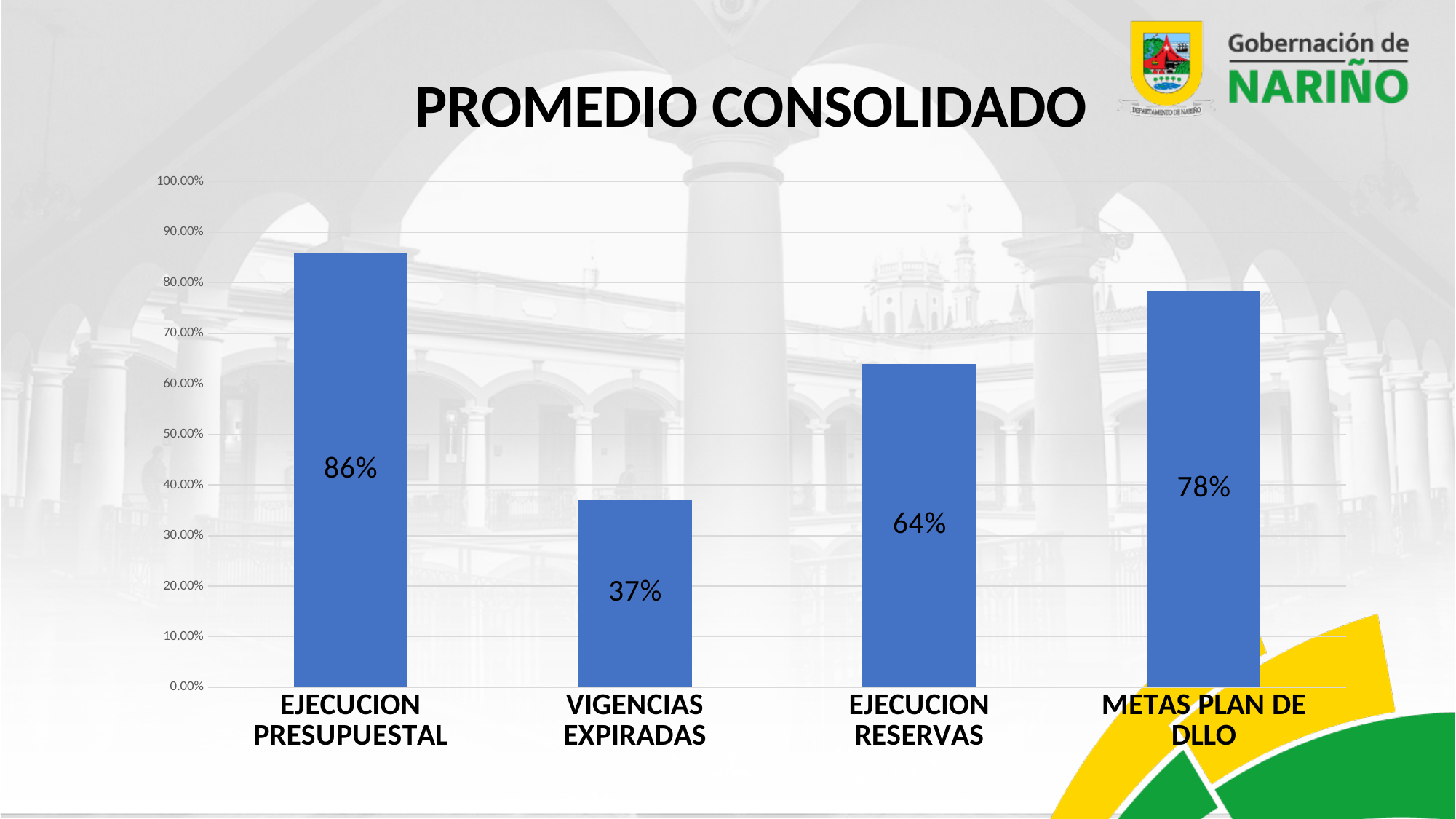
What is the value for VIGENCIAS EXPIRADAS? 37% Which is larger, the value for EJECUCION RESERVAS or the value for METAS PLAN DE DLLO? METAS PLAN DE DLLO Which category has the lowest value? VIGENCIAS EXPIRADAS How many categories are shown in the chart? 4 Is the value for EJECUCION RESERVAS greater or less than 70.00%? less What is the difference between the values for EJECUCION PRESUPUESTAL and VIGENCIAS EXPIRADAS? 49% What kind of chart is shown on the slide? bar chart What is the value for EJECUCION PRESUPUESTAL? 86% What is the difference between the values for METAS PLAN DE DLLO and EJECUCION RESERVAS? 14% Which category has the highest value? EJECUCION PRESUPUESTAL What is the value for EJECUCION RESERVAS? 64% What is the value for METAS PLAN DE DLLO? 78%